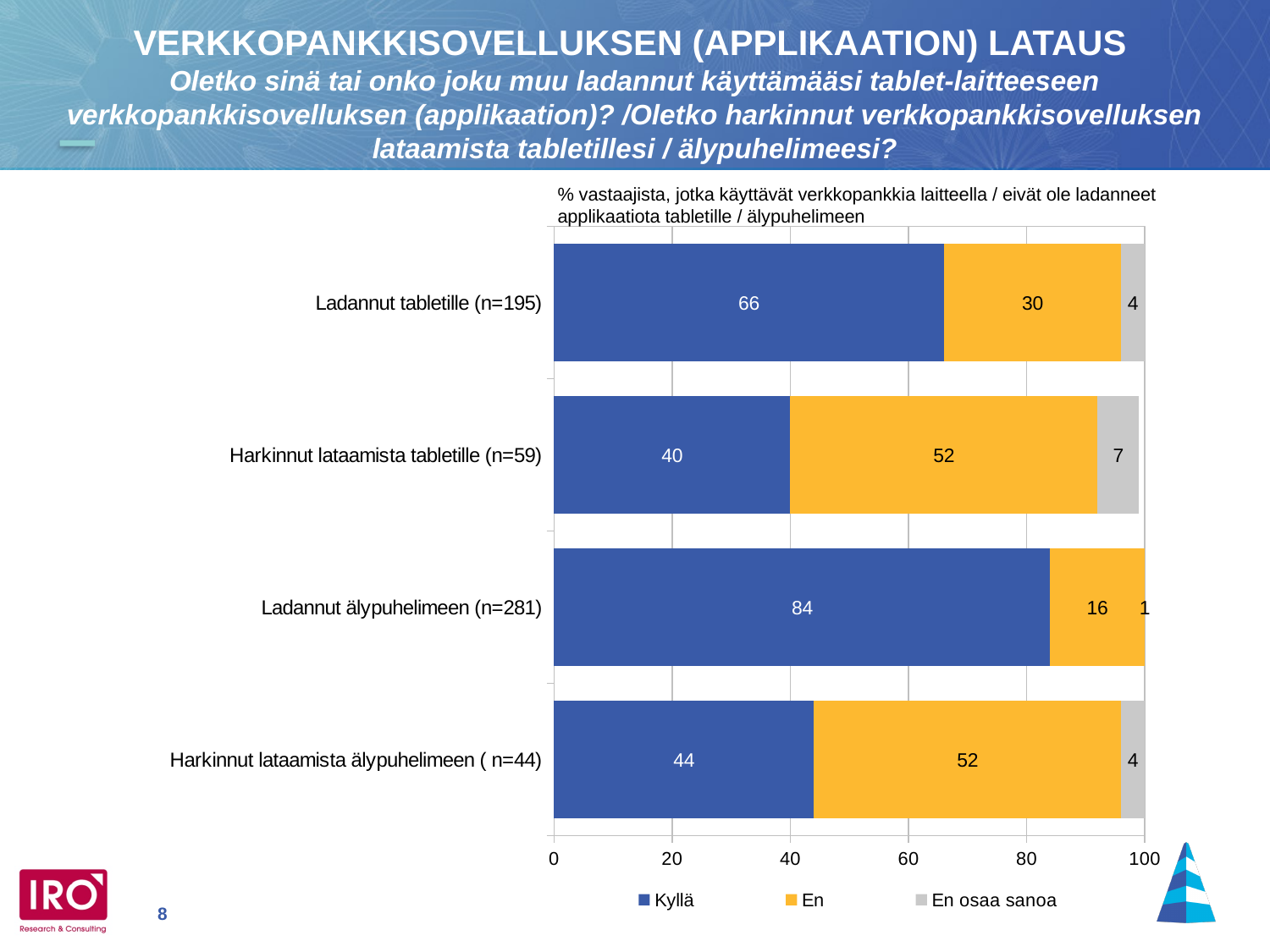
What is the "En osaa sanoa" value for "Ladannut älypuhelimeen (n=281)"? 1 Which category has the highest "Kyllä" value? Ladannut älypuhelimeen (n=281) Which category has the lowest "Kyllä" value? Harkinnut lataamista tabletille (n=59) How many categories are shown on the chart? 4 What kind of chart is shown on the slide? Stacked bar chart What is the total of the stacked bar for "Harkinnut lataamista tabletille (n=59)"? 99 How many series does the legend list? 3 What is the "En" value for "Harkinnut lataamista tabletille (n=59)"? 52 What is the "Kyllä" value for "Ladannut tabletille (n=195)"? 66 What is the "Kyllä" value for "Harkinnut lataamista älypuhelimeen ( n=44)"? 44 Which is larger: the "En" value for "Ladannut tabletille (n=195)" or the "En" value for "Ladannut älypuhelimeen (n=281)"? Ladannut tabletille (n=195) What is the difference between the "Kyllä" values for "Ladannut älypuhelimeen (n=281)" and "Ladannut tabletille (n=195)"? 18